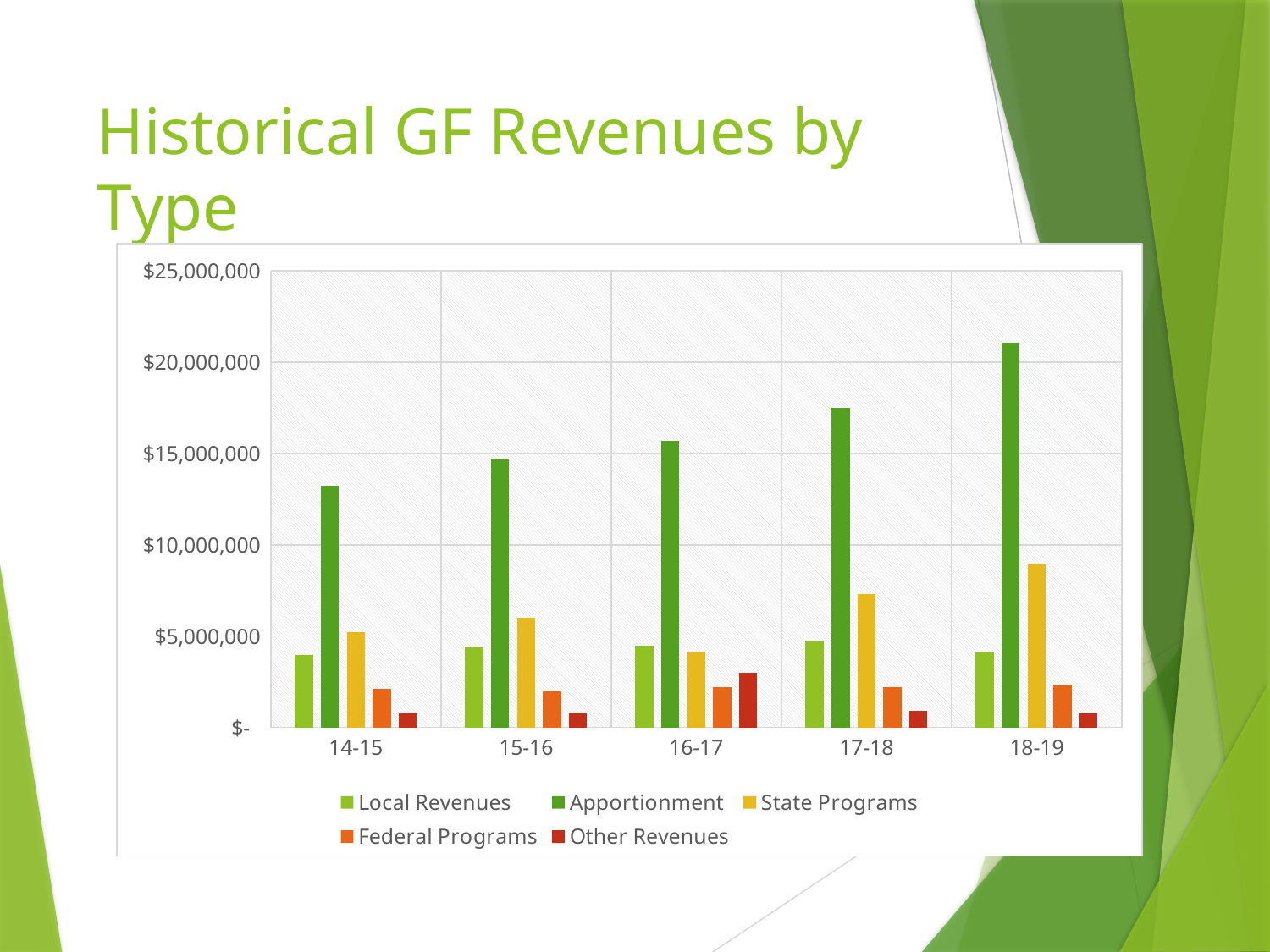
How many fiscal years are shown on the x axis? 5 In 18-19, which is larger: State Programs or Local Revenues? State Programs How many series does the legend list? 5 Does Apportionment rise or fall from 14-15 to 18-19? Rise Is the Apportionment value for 18-19 greater or less than $20,000,000? greater Is the Apportionment value for 14-15 greater or less than $15,000,000? less In 16-17, which is larger: Federal Programs or Other Revenues? Other Revenues What is the title of the slide? Historical GF Revenues by Type In which year is Apportionment highest? 18-19 Is the State Programs value for 17-18 greater or less than $5,000,000? greater What kind of chart is shown on the slide? Bar chart In which year is Other Revenues highest? 16-17